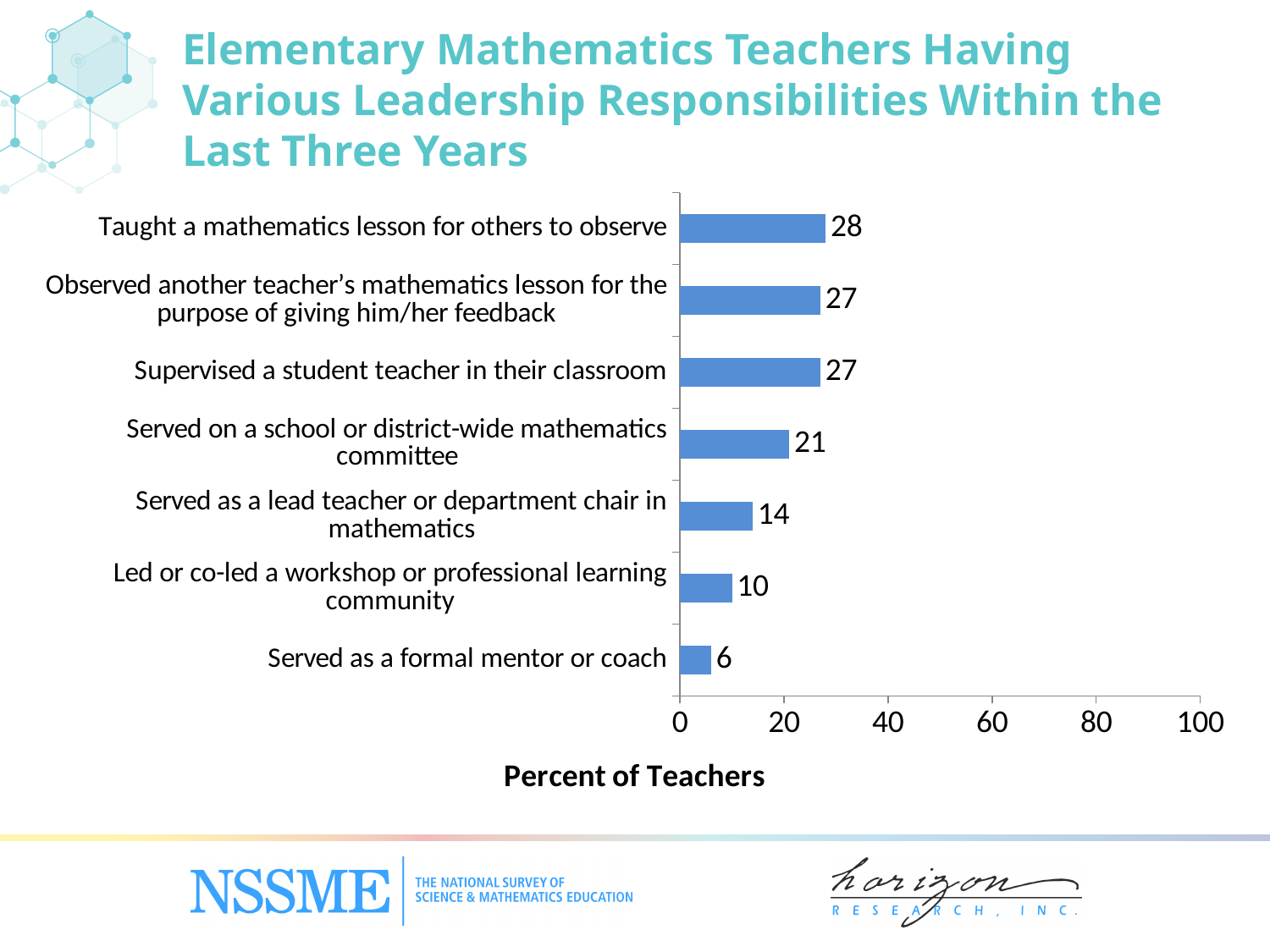
What percent of teachers led or co-led a workshop or professional learning community? 10 What percent of teachers served as a formal mentor or coach? 6 How many leadership responsibilities are shown in the chart? 7 Is the value for teachers who taught a mathematics lesson for others to observe greater or less than 40? less What kind of chart is shown on the slide? Bar chart What percent of teachers served on a school or district-wide mathematics committee? 21 Which is larger: the percent who served on a school or district-wide mathematics committee or the percent who led or co-led a workshop or professional learning community? Served on a school or district-wide mathematics committee What is the label of the horizontal axis? Percent of Teachers What is the difference in percent between teachers who supervised a student teacher in their classroom and those who served as a lead teacher or department chair in mathematics? 13 What percent of teachers taught a mathematics lesson for others to observe? 28 Which leadership responsibility has the highest percent of teachers? Taught a mathematics lesson for others to observe Which leadership responsibility has the lowest percent of teachers? Served as a formal mentor or coach